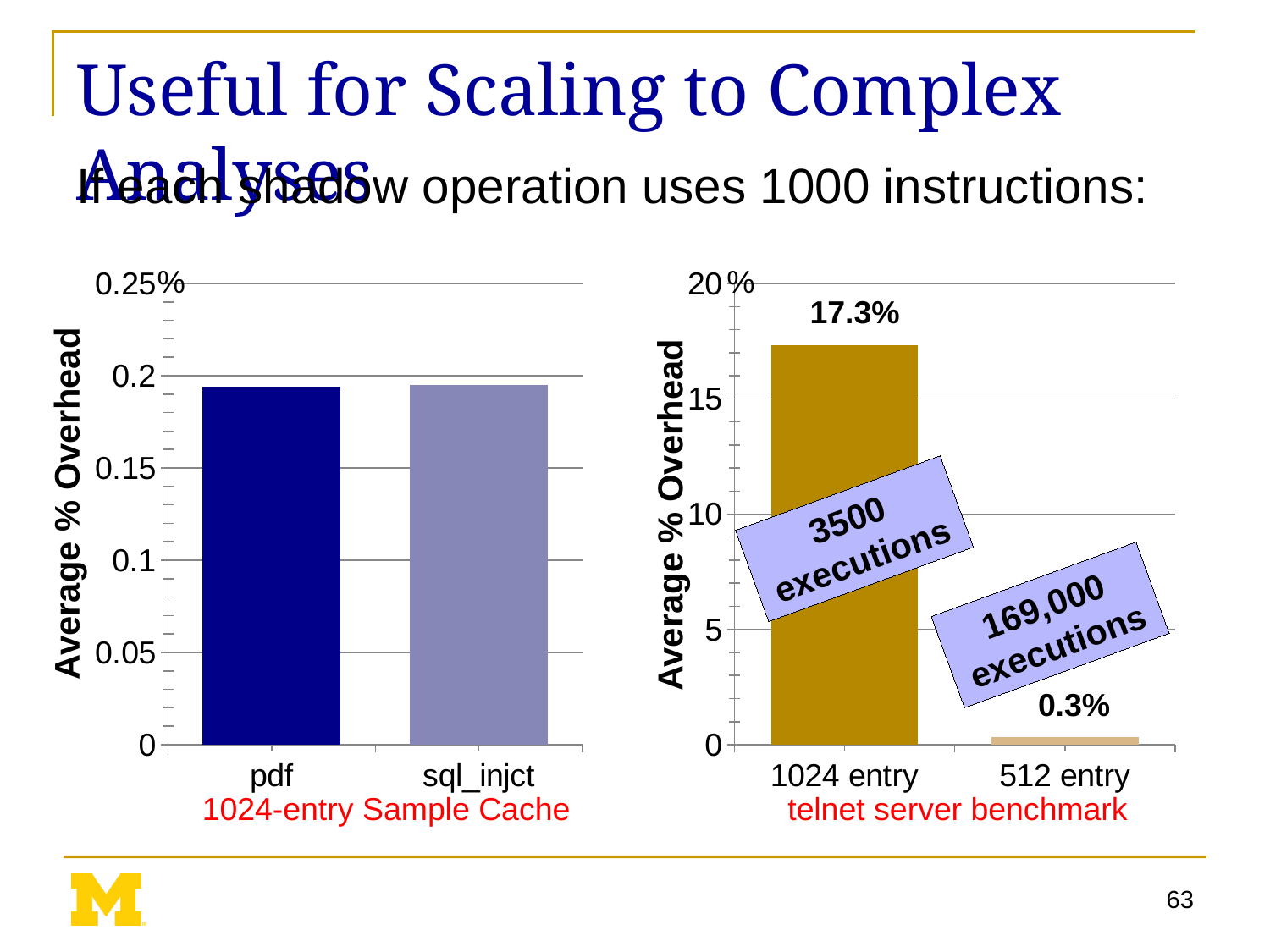
In the telnet server benchmark chart, what is the difference in average % overhead between 1024 entry and 512 entry? 17.0% How many categories are shown in the telnet server benchmark chart? 2 In the telnet server benchmark chart, is the value for 1024 entry greater or less than 15? greater In the 1024-entry Sample Cache chart, is the value for pdf greater or less than 0.15? greater What is the y-axis label of the telnet server benchmark chart? Average % Overhead How many categories are shown in the 1024-entry Sample Cache chart? 2 In the telnet server benchmark chart, which category has the lowest average % overhead? 512 entry In the telnet server benchmark chart, what is the average % overhead for 1024 entry? 17.3% What kind of chart is the 1024-entry Sample Cache chart? bar chart In the telnet server benchmark chart, what is the average % overhead for 512 entry? 0.3% In the telnet server benchmark chart, which category has the highest average % overhead? 1024 entry In the 1024-entry Sample Cache chart, is the value for sql_injct greater or less than 0.2? less